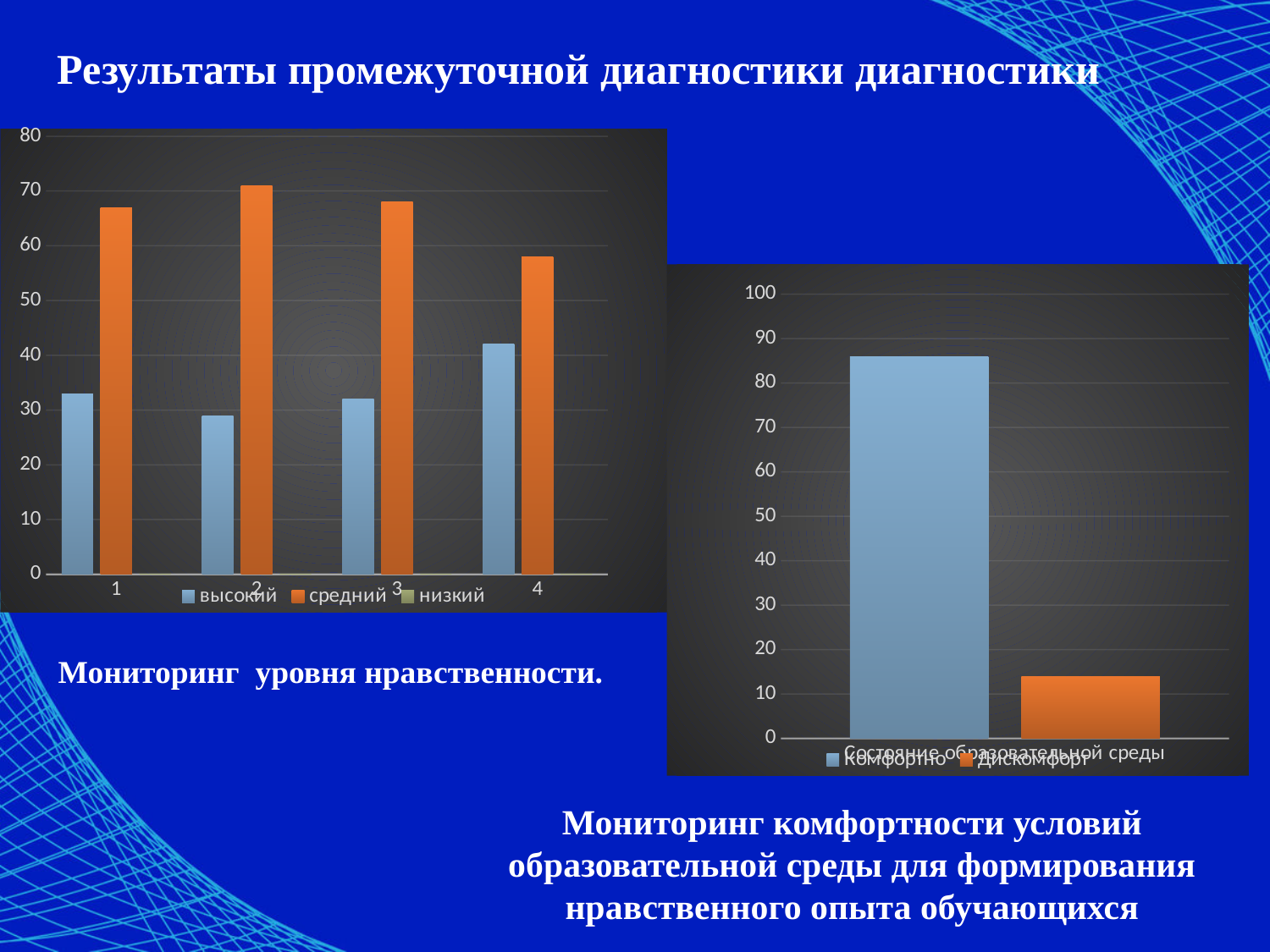
How many categories are shown on the x axis of the left chart? 4 In the left chart, is the value for высокий in category 4 greater or less than 30? greater In the right chart, is the value for Комфортно greater or less than 80? greater In the left chart, is the value for средний in category 1 greater or less than 60? greater What kind of chart is the left chart (Мониторинг уровня нравственности)? bar chart In the left chart, which category has the highest value for высокий? 4 How many series does the legend of the left chart list? 3 How many series does the legend of the right chart list? 2 In the left chart, which is larger for category 3: высокий or средний? средний What kind of chart is the right chart (Мониторинг комфортности условий образовательной среды)? bar chart In the left chart, which series has the lowest values across all categories? низкий In the right chart, which is larger: Комфортно or Дискомфорт? Комфортно